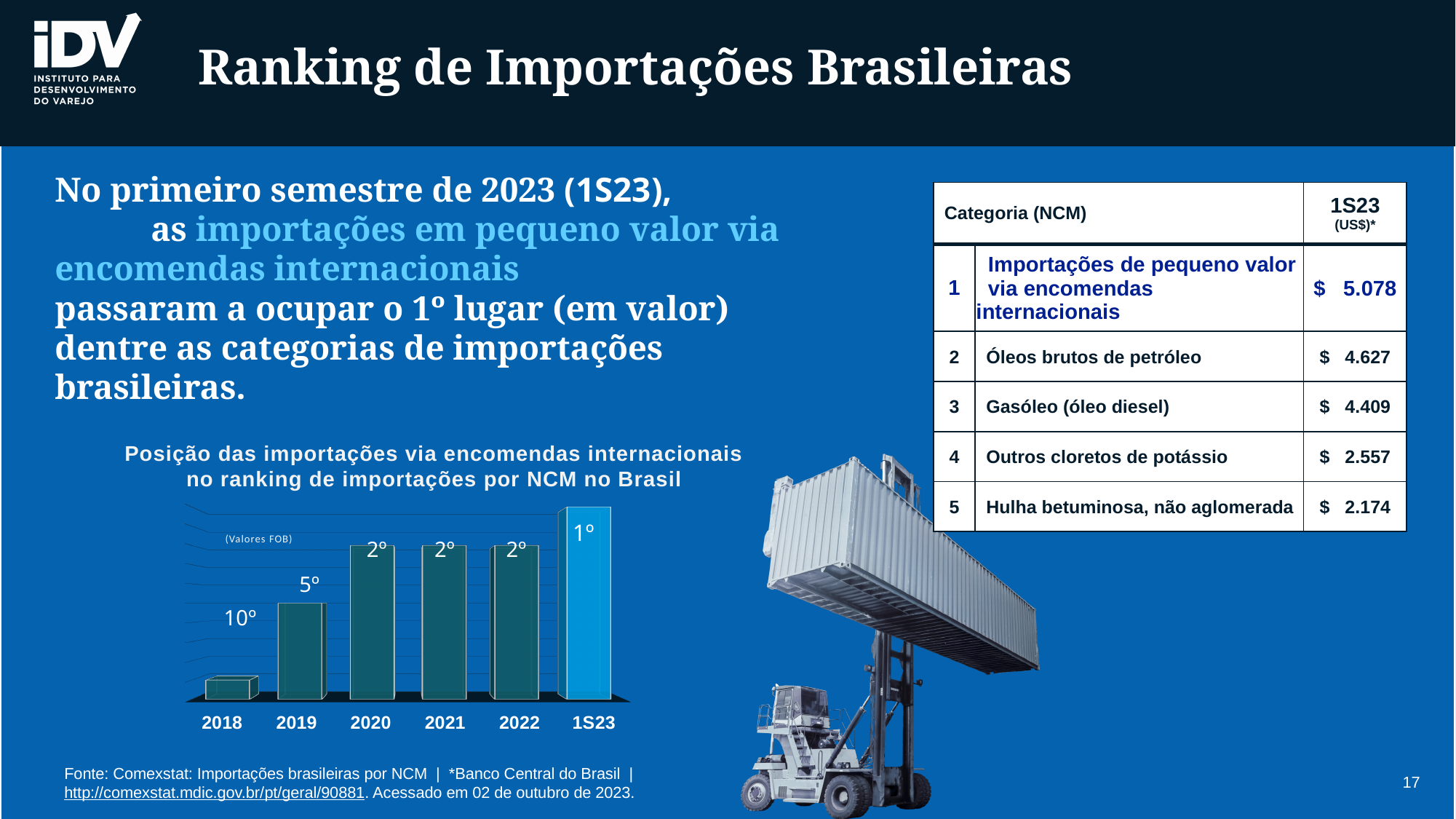
What ranking position is shown for 2020 in the chart? 2º What kind of chart is used to show the ranking position of imports via international orders? Bar chart How many periods in the chart show a ranking position of 2º? 3 What ranking position is shown for 2018 in the chart 'Posição das importações via encomendas internacionais no ranking de importações por NCM no Brasil'? 10º What ranking position is shown for 2019 in the chart? 5º Which period has the tallest bar in the chart? 1S23 What ranking position is shown for 1S23 in the chart? 1º How many periods (bars) are shown on the x axis of the chart? 6 Which bar in the chart is highlighted in a lighter blue colour than the others? 1S23 Do the bars in the chart rise or fall from 2018 to 1S23? Rise Which period has the shortest bar in the chart? 2018 What ranking position is shown for 2022 in the chart? 2º